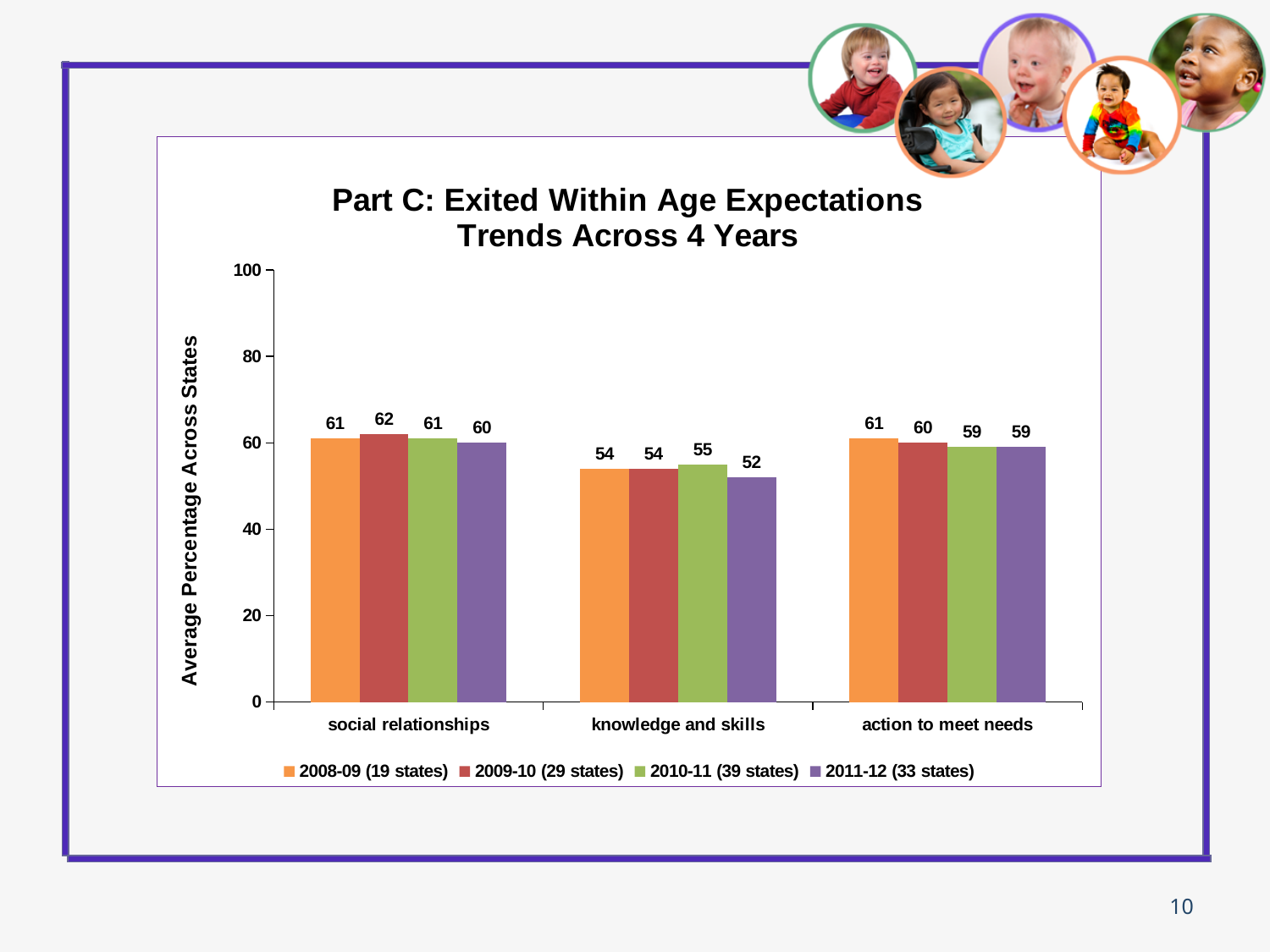
Is the value for 2009-10 (29 states) in the action to meet needs category greater or less than 80? less How many series does the legend list? 4 Which series has the highest value in the knowledge and skills category? 2010-11 (39 states) What is the value for 2011-12 (33 states) in the knowledge and skills category? 52 What is the value for 2008-09 (19 states) in the action to meet needs category? 61 What kind of chart is shown on the slide? bar chart Which is larger: the 2008-09 (19 states) value for social relationships or the 2008-09 (19 states) value for knowledge and skills? social relationships Which category has the lowest value for the 2011-12 (33 states) series? knowledge and skills What is the difference between the 2010-11 (39 states) and 2011-12 (33 states) values for knowledge and skills? 3 How many categories are shown on the x axis? 3 What is the label of the y axis? Average Percentage Across States What is the value for 2009-10 (29 states) in the social relationships category? 62